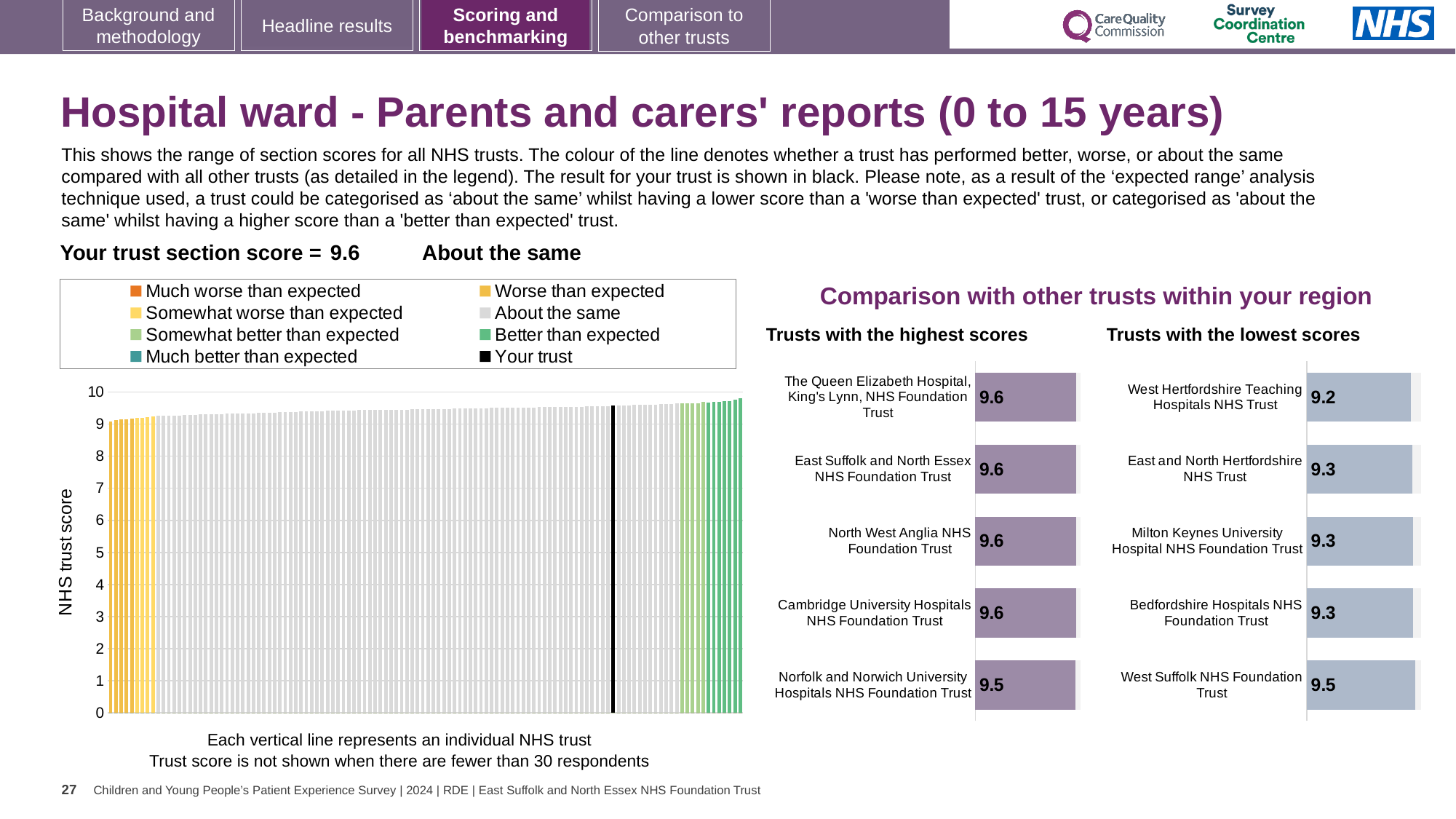
In the 'Trusts with the highest scores' chart, which trust has the lowest score? Norfolk and Norwich University Hospitals NHS Foundation Trust In the 'Trusts with the highest scores' chart, what is the score for Norfolk and Norwich University Hospitals NHS Foundation Trust? 9.5 How many trusts are shown in the 'Trusts with the highest scores' chart? 5 In the 'Trusts with the lowest scores' chart, what is the difference between the scores of West Suffolk NHS Foundation Trust and West Hertfordshire Teaching Hospitals NHS Trust? 0.3 In the large chart on the left, do the trust scores rise or fall from left to right along the x axis? Rise What kind of chart is the large chart on the left showing the range of section scores for all NHS trusts? Bar chart How many entries does the legend above the large chart on the left list? 8 In the 'Trusts with the lowest scores' chart, which trust has the highest score? West Suffolk NHS Foundation Trust In the 'Trusts with the lowest scores' chart, which trust has the lowest score? West Hertfordshire Teaching Hospitals NHS Trust In the 'Trusts with the lowest scores' chart, which has the larger score: Milton Keynes University Hospital NHS Foundation Trust or West Hertfordshire Teaching Hospitals NHS Trust? Milton Keynes University Hospital NHS Foundation Trust In the 'Trusts with the highest scores' chart, what is the score for Cambridge University Hospitals NHS Foundation Trust? 9.6 In the 'Trusts with the lowest scores' chart, what is the score for West Hertfordshire Teaching Hospitals NHS Trust? 9.2